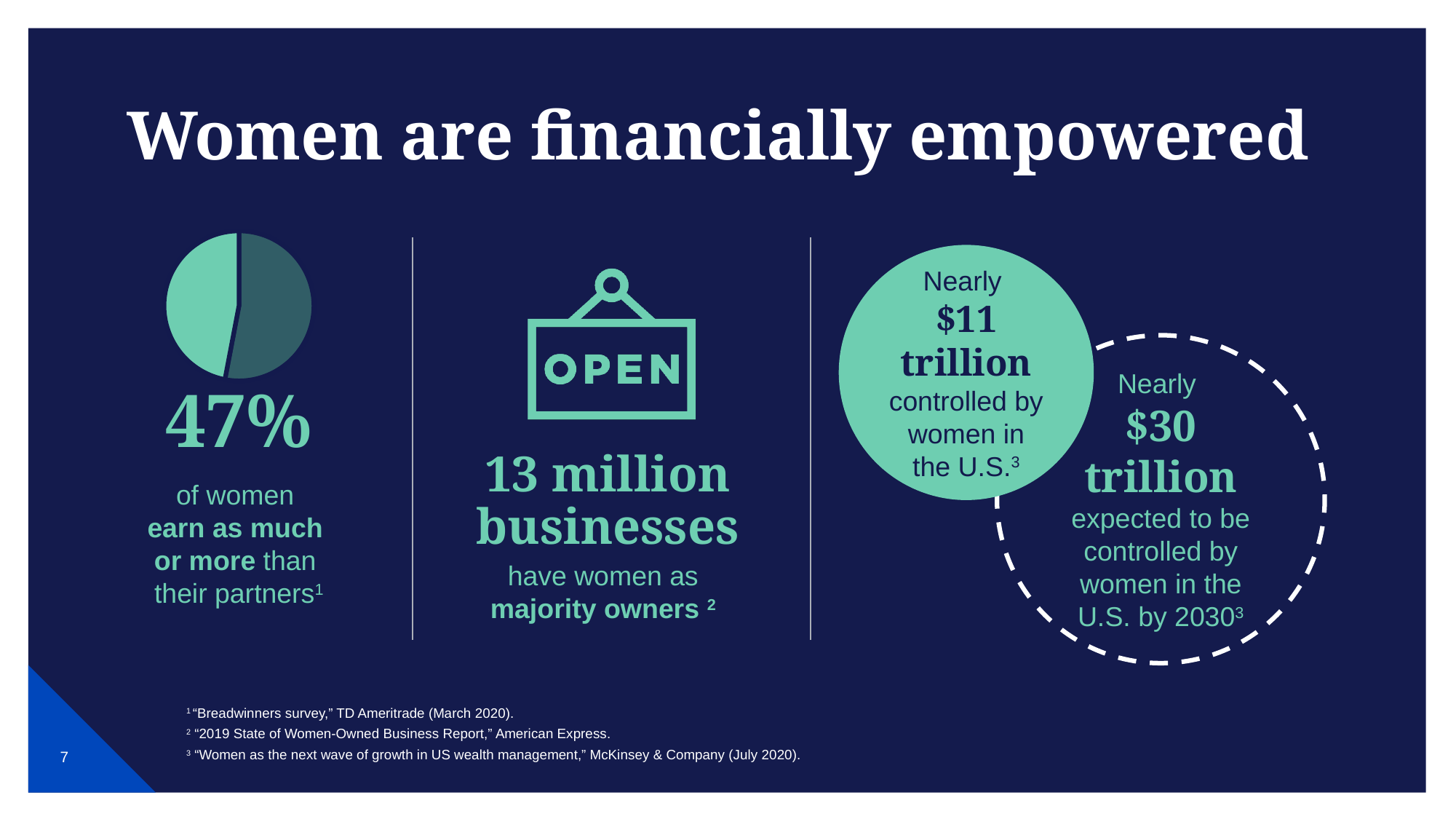
What two colours are used for the slices of the pie chart on the left of the slide? light teal and dark teal Is the light teal slice of the pie chart on the left greater or less than 50% of the pie? less What kind of chart is shown on the left of the slide, above the 47% figure? pie chart How many slices does the pie chart on the left of the slide have? 2 What does the 47% slice of the pie chart on the left represent, according to the text below it? women who earn as much or more than their partners What share of the pie chart on the left does the light teal slice represent, according to the figure printed below it? 47%